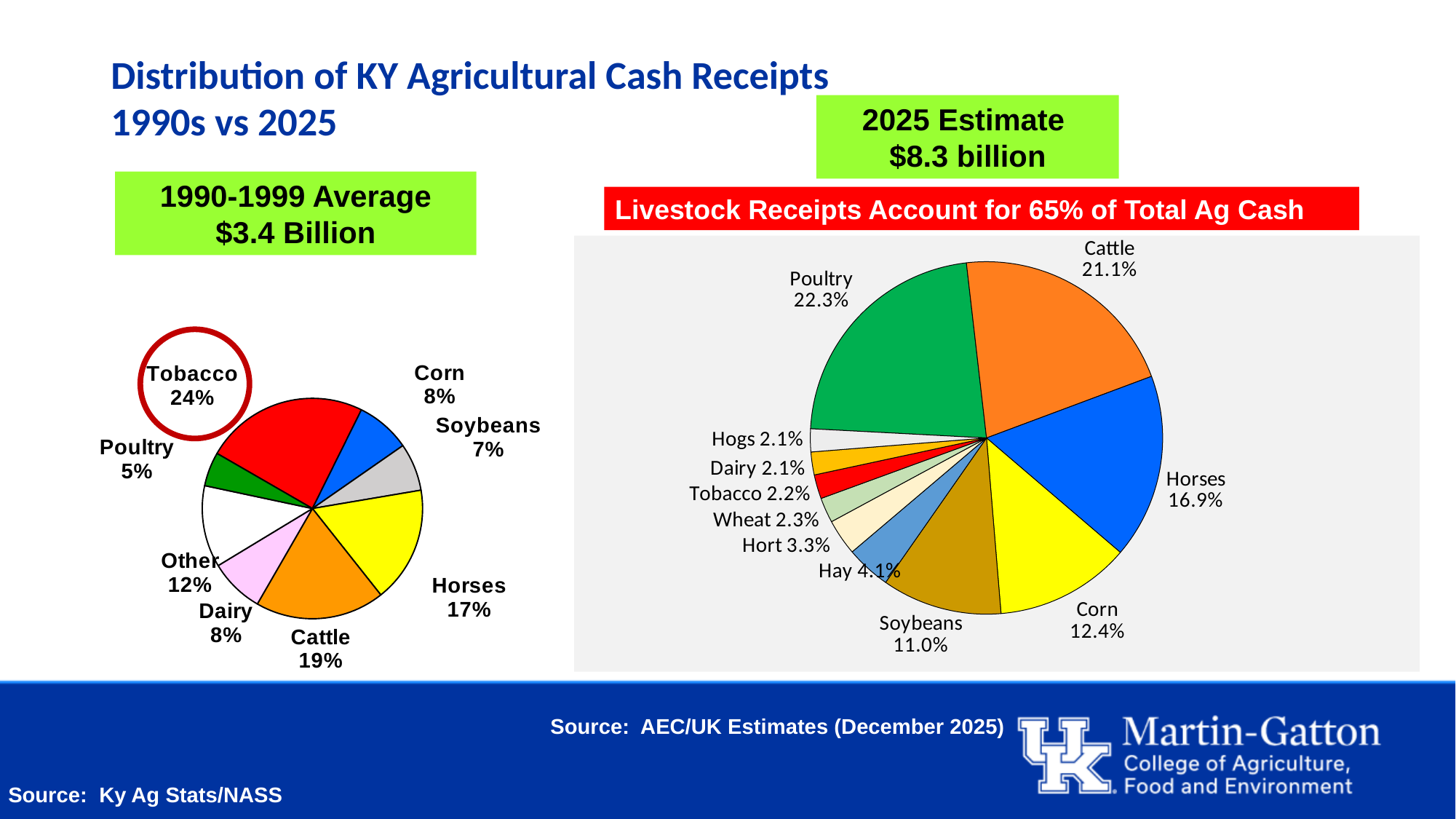
In the 2025 Estimate pie chart, what is the difference between the Cattle share and the Horses share? 4.2% In the 1990-1999 Average pie chart, what share of cash receipts came from Tobacco? 24% In the 1990-1999 Average pie chart, which category has the smallest share? Poultry What type of chart is used for the 1990-1999 Average data? Pie chart How many slices does the 2025 Estimate pie chart have? 11 In the 2025 Estimate pie chart, what share of cash receipts is attributed to Poultry? 22.3% In the 2025 Estimate pie chart, what share is shown for Hay? 4.1% In the 1990-1999 Average pie chart, which is larger: the Cattle share or the Horses share? Cattle Which category is circled in red on the 1990-1999 Average pie chart? Tobacco How many slices does the 1990-1999 Average pie chart have? 8 In the 2025 Estimate pie chart, which category has the largest share? Poultry In the 1990-1999 Average pie chart, what is the combined share of Corn and Soybeans? 15%